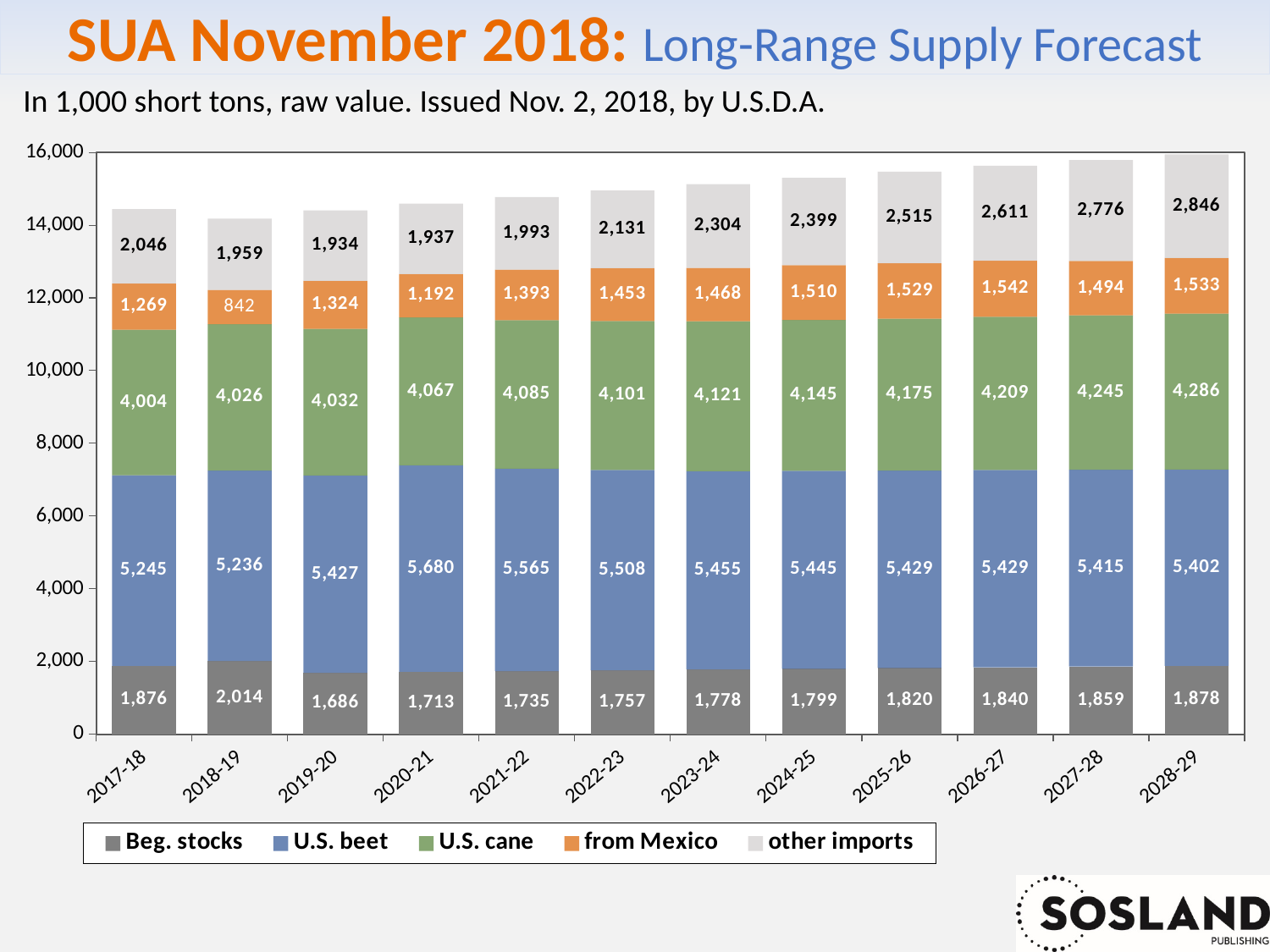
What is the total of the stacked bar for 2017-18? 14,440 What is the value for U.S. beet in 2020-21? 5,680 What is the difference between other imports in 2028-29 and in 2017-18? 800 How many years are shown on the x axis? 12 What is the value for other imports in 2023-24? 2,304 What is the value for from Mexico in 2018-19? 842 Which is larger, U.S. cane in 2028-29 or U.S. cane in 2017-18? 2028-29 What kind of chart is shown? Stacked bar chart In which year is the from Mexico value lowest? 2018-19 How many series does the legend list? 5 In which year is the U.S. beet value highest? 2020-21 In which year is the Beg. stocks value lowest? 2019-20